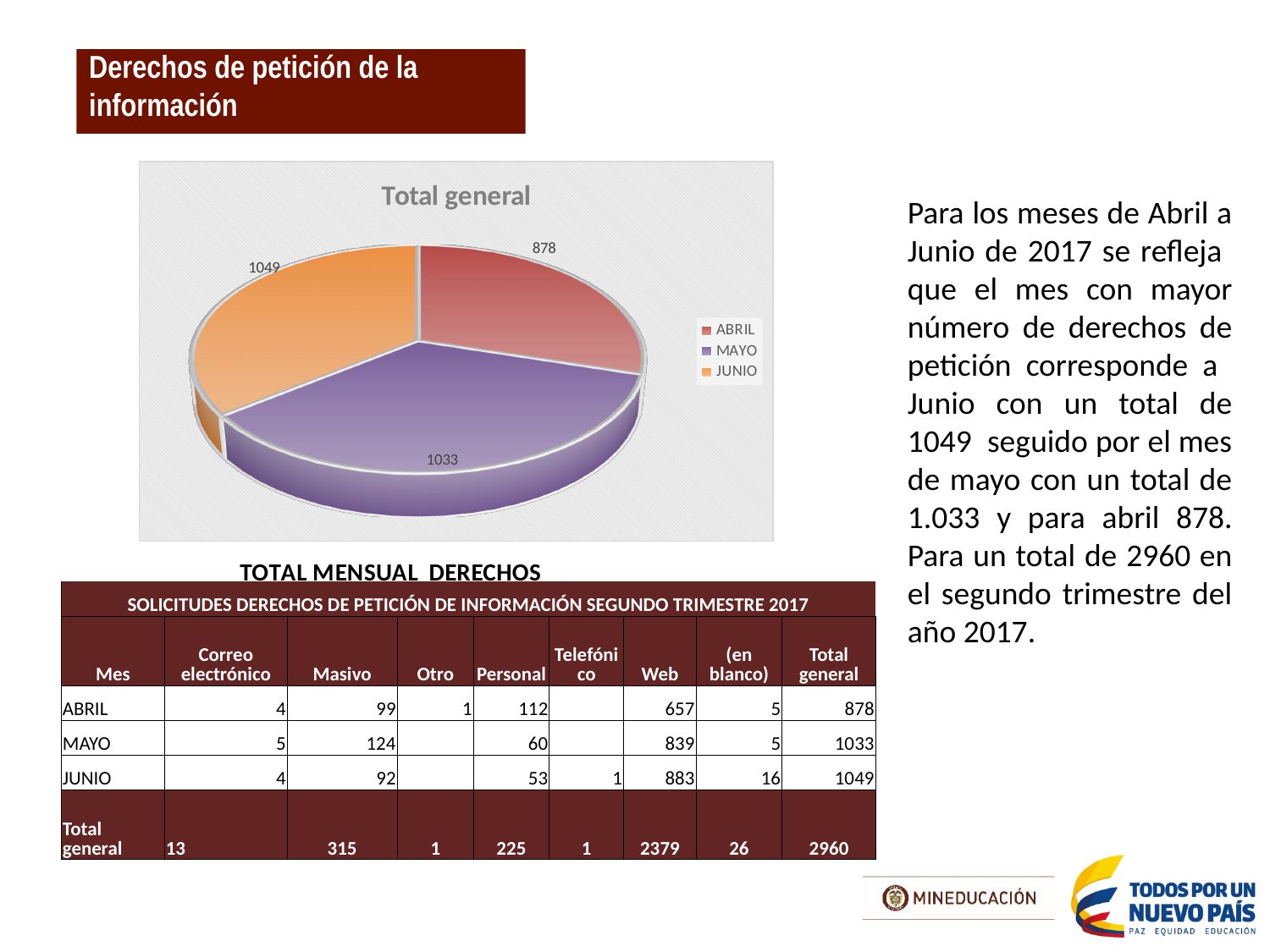
What is the difference between the values for JUNIO and MAYO in the pie chart? 16 What is the value shown for MAYO in the pie chart? 1033 Which is larger in the pie chart, the value for MAYO or the value for ABRIL? MAYO What is the value shown for ABRIL in the pie chart? 878 What is the title of the pie chart? Total general How many slices does the pie chart have? 3 Which month has the largest slice in the pie chart? JUNIO What is the difference between the values for MAYO and ABRIL in the pie chart? 155 What kind of chart is shown on the slide? Pie chart Which month is shown in orange in the pie chart? JUNIO Which month has the smallest slice in the pie chart? ABRIL What is the value shown for JUNIO in the pie chart? 1049